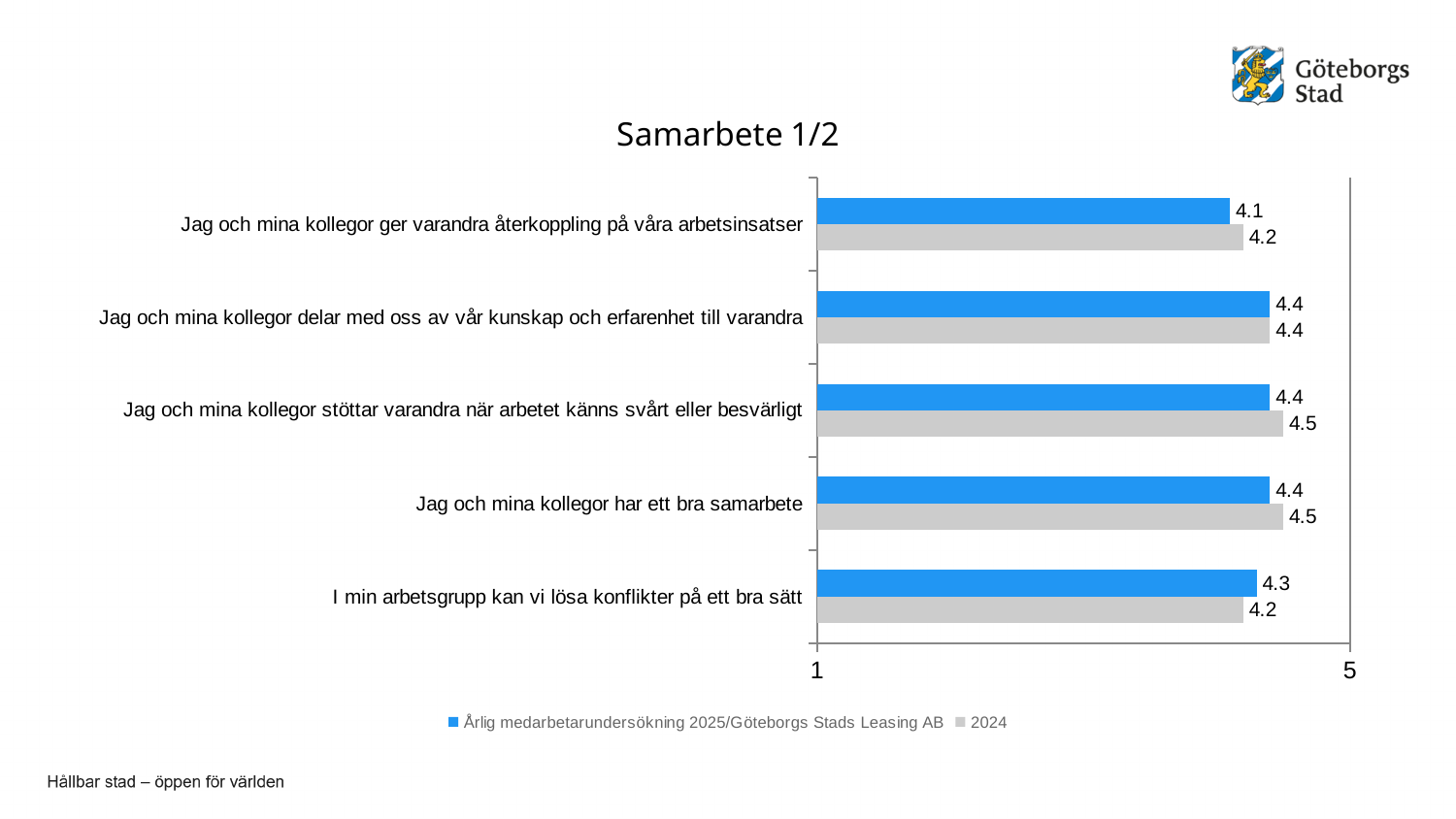
For "I min arbetsgrupp kan vi lösa konflikter på ett bra sätt", which is larger: the 2025 value or the 2024 value? 2025 What is the 2024 value for "Jag och mina kollegor stöttar varandra när arbetet känns svårt eller besvärligt"? 4.5 Which statement has the lowest value in the 2025 series? Jag och mina kollegor ger varandra återkoppling på våra arbetsinsatser What is the 2025 value for "I min arbetsgrupp kan vi lösa konflikter på ett bra sätt"? 4.3 How many categories (statements) are shown in the chart? 5 What is the title of the chart? Samarbete 1/2 Which colour represents the 2024 series? grey How many series does the legend list? 2 What is the difference between the 2024 and 2025 values for "Jag och mina kollegor har ett bra samarbete"? 0.1 What type of chart is shown on the slide? bar chart What is the 2025 (Årlig medarbetarundersökning 2025/Göteborgs Stads Leasing AB) value for "Jag och mina kollegor ger varandra återkoppling på våra arbetsinsatser"? 4.1 What is the 2024 value for "Jag och mina kollegor delar med oss av vår kunskap och erfarenhet till varandra"? 4.4